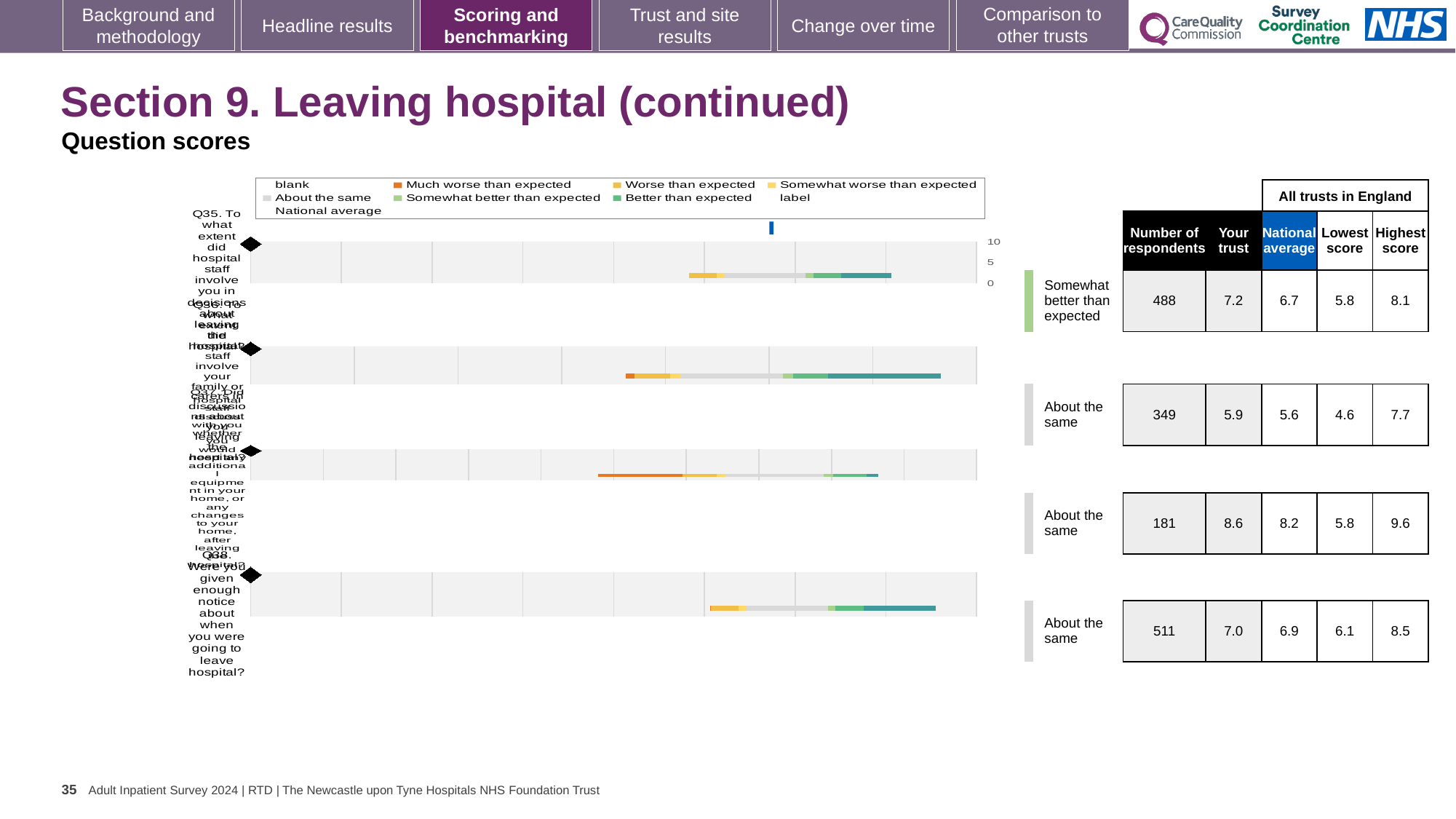
How many respondents answered Q35? 488 How many of the four questions are categorised as 'About the same'? 3 What is the national average score for Q38 (given enough notice about when you were going to leave hospital)? 6.9 For Q38, which is larger: the 'Your trust' score or the national average? Your trust What is the 'Your trust' score for Q35 (involving you in decisions about leaving hospital)? 7.2 What is the highest 'Your trust' score shown in the table? 8.6 What is the lowest value in the 'Lowest score' column of the table? 4.6 By how much does the 'Your trust' score for Q35 exceed the national average for Q35? 0.5 How many questions (bars) are plotted in the chart? 4 What kind of chart is shown on the slide? bar chart What benchmark category is shown for Q35? Somewhat better than expected What is the difference between the highest score and the lowest score for Q38? 2.4